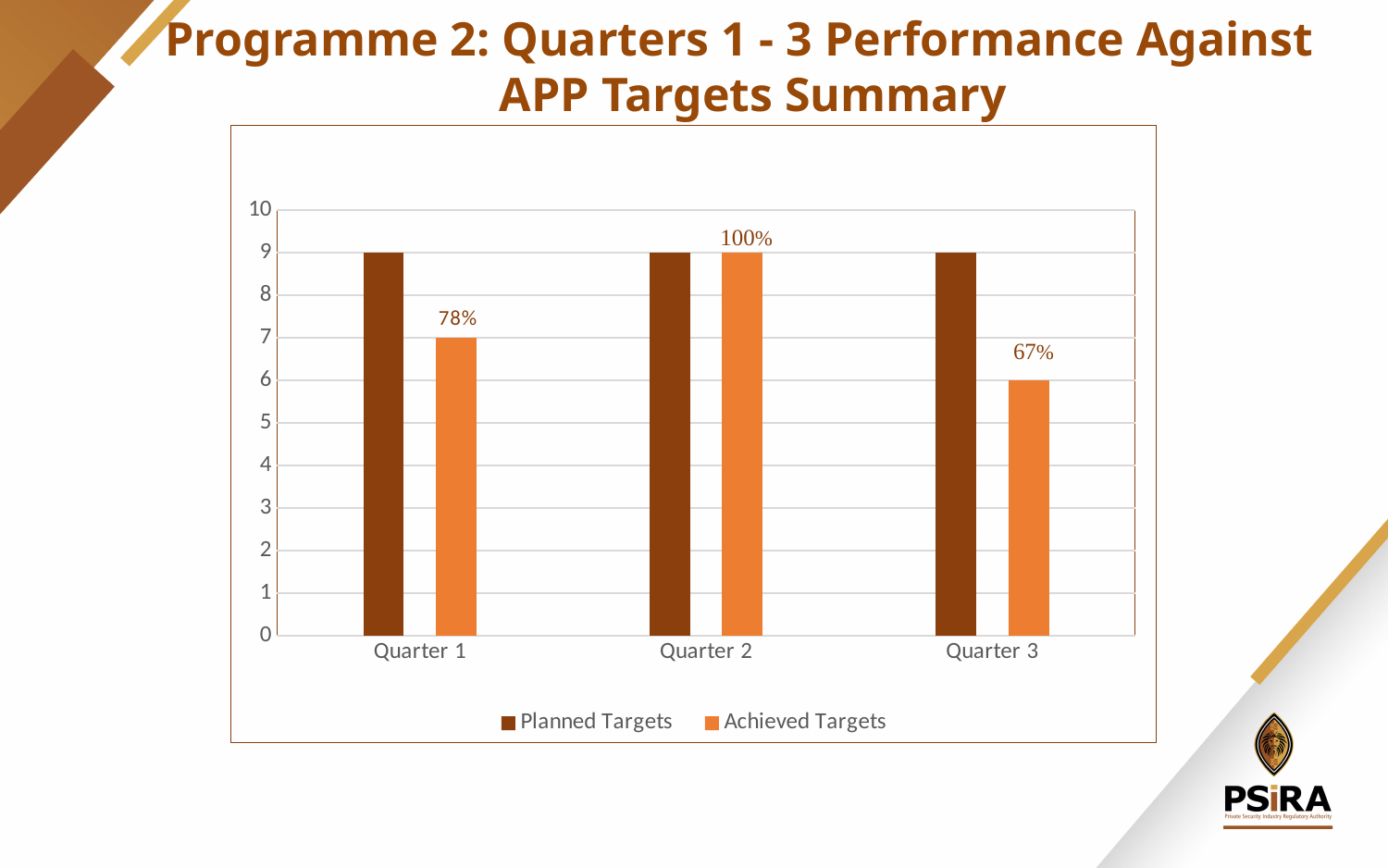
What type of chart is shown on the slide? Bar chart What data label is shown above the Achieved Targets bar for Quarter 3? 67% Which quarter has the lowest Achieved Targets bar? Quarter 3 How many series does the legend list? 2 Is the Achieved Targets bar for Quarter 1 greater or less than 8? less How many quarters are shown on the x axis? 3 What is the value of the Planned Targets bar for Quarter 2? 9 Which quarter has the highest Achieved Targets bar? Quarter 2 What is the difference between the Planned Targets and Achieved Targets bars for Quarter 1? 2 What data label is shown above the Achieved Targets bar for Quarter 1? 78% What is the value of the Achieved Targets bar for Quarter 3? 6 What data label is shown above the Achieved Targets bar for Quarter 2? 100%